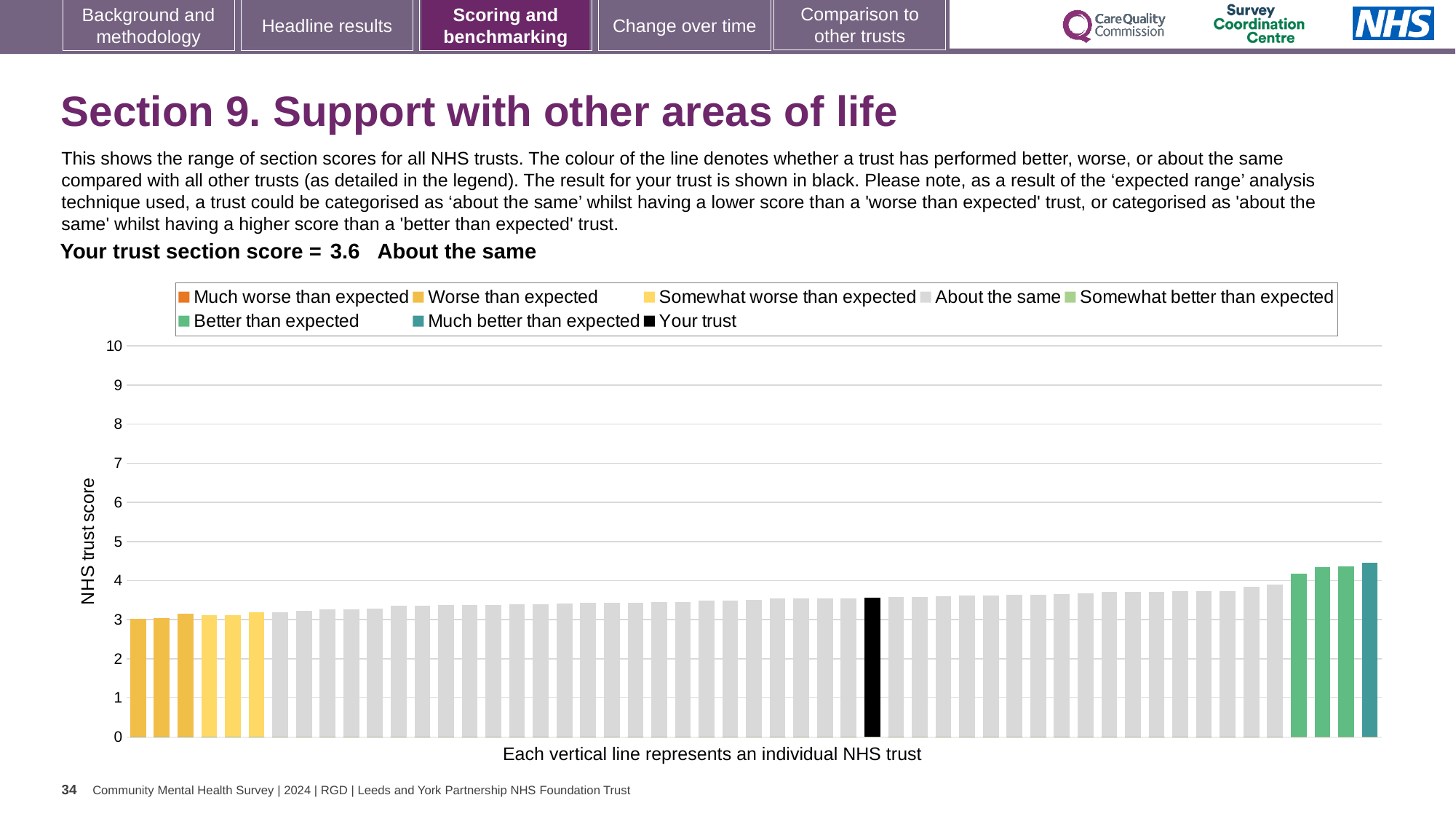
How many entries does the chart legend list? 8 How many bars are coloured as 'Much better than expected'? 1 Is the value of the tallest bar (Much better than expected) greater or less than 4? greater Is the value of the leftmost bar greater or less than 4? less How many bars are coloured as 'Worse than expected'? 3 Do the bar values rise or fall from left to right along the x axis? Rise How many bars are coloured as 'Better than expected'? 3 What is the label on the vertical axis of the chart? NHS trust score Which legend category does the tallest bar on the chart belong to? Much better than expected Is the value of the black 'Your trust' bar greater or less than 4? less What kind of chart is shown on the slide? Bar chart What is the section score for your trust shown on the slide? 3.6